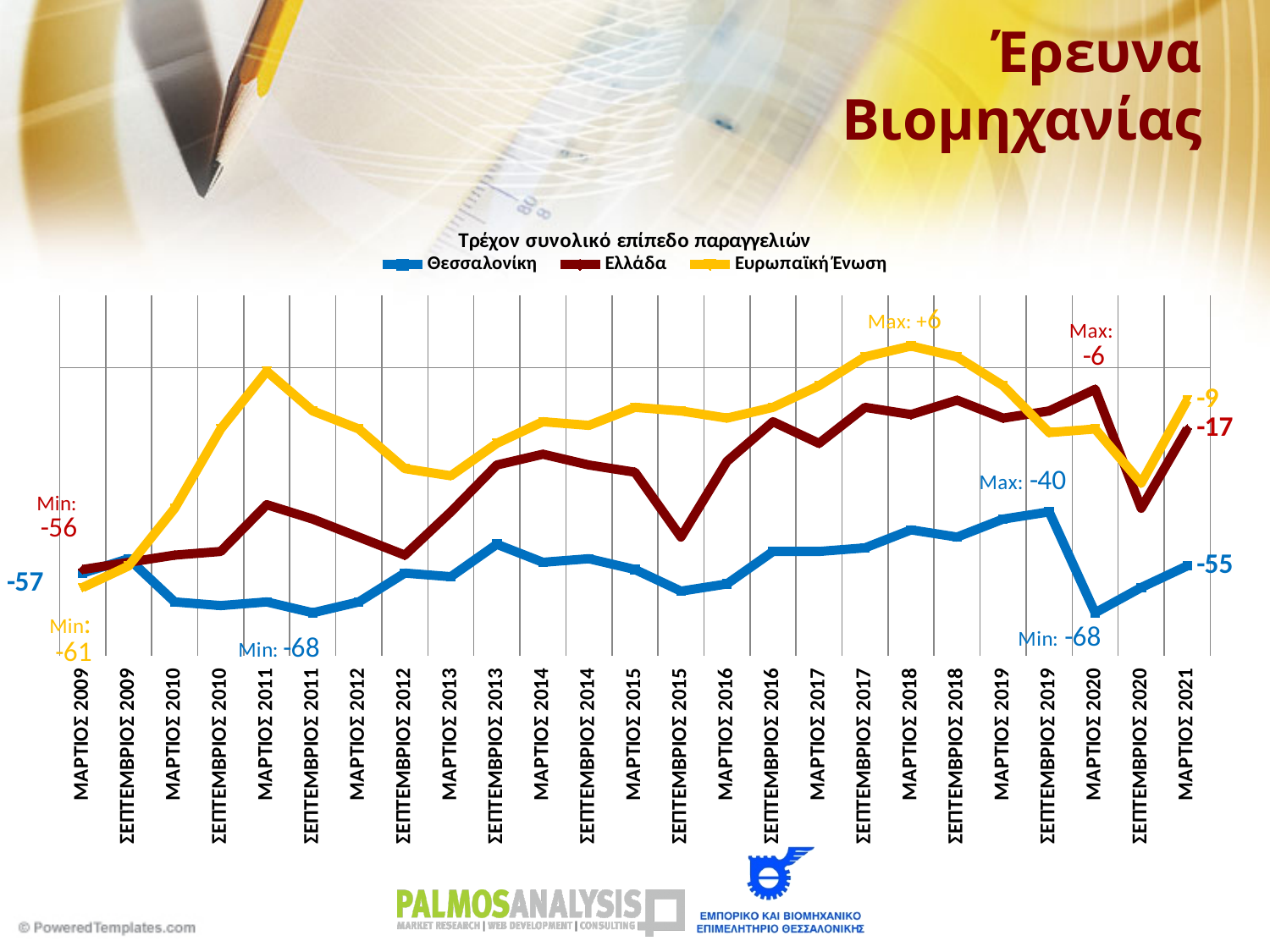
What is the maximum value reached by the Ευρωπαϊκή Ένωση series, and when? +6, ΜΑΡΤΙΟΣ 2018 Which series has the higher value in ΜΑΡΤΙΟΣ 2021, Ελλάδα or Θεσσαλονίκη? Ελλάδα What is the value for Ευρωπαϊκή Ένωση in ΜΑΡΤΙΟΣ 2021? -9 What is the title of the chart? Τρέχον συνολικό επίπεδο παραγγελιών How many time points are plotted along the x axis? 25 What is the value for Θεσσαλονίκη in ΜΑΡΤΙΟΣ 2009? -57 What is the difference between the Ελλάδα and Θεσσαλονίκη values in ΜΑΡΤΙΟΣ 2021? 38 What is the value for Ελλάδα in ΜΑΡΤΙΟΣ 2021? -17 What kind of chart is shown on the slide? line chart What is the minimum value of the Ελλάδα series? -56 How many series does the legend list? 3 What is the maximum value reached by the Θεσσαλονίκη series? -40